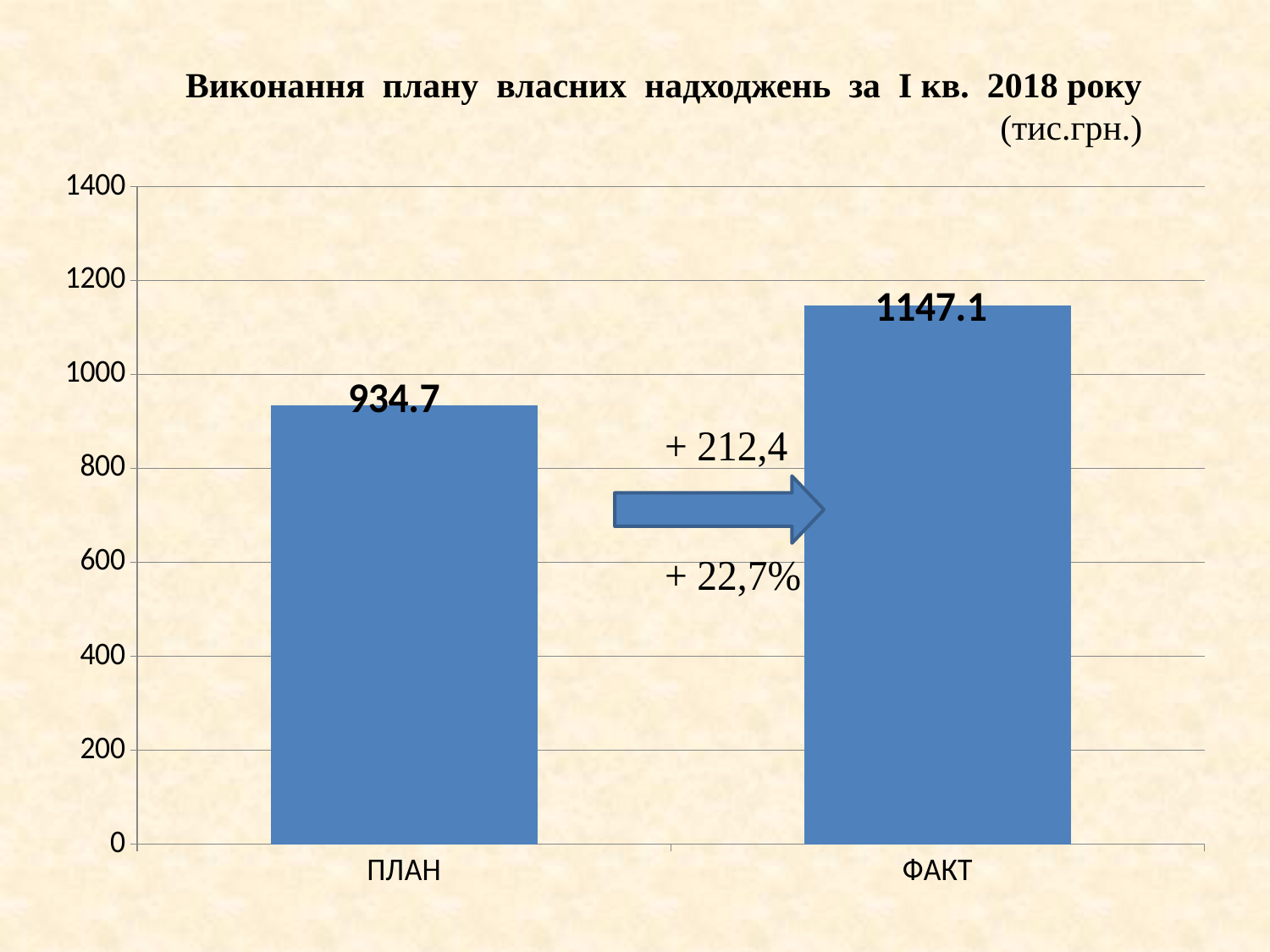
Do the values rise or fall from ПЛАН to ФАКТ? rise Which category has the lowest value? ПЛАН What is the value for ФАКТ? 1147.1 Is the value for ПЛАН greater or less than 1000? less What kind of chart is shown on the slide? bar chart Which category has the highest value? ФАКТ Which is larger, the value for ПЛАН or the value for ФАКТ? ФАКТ What is the value for ПЛАН? 934.7 What percentage increase is shown next to the arrow between the bars? + 22,7% What is the difference between the values for ФАКТ and ПЛАН? 212.4 Is the value for ФАКТ greater or less than 1000? greater How many categories are shown on the x axis? 2